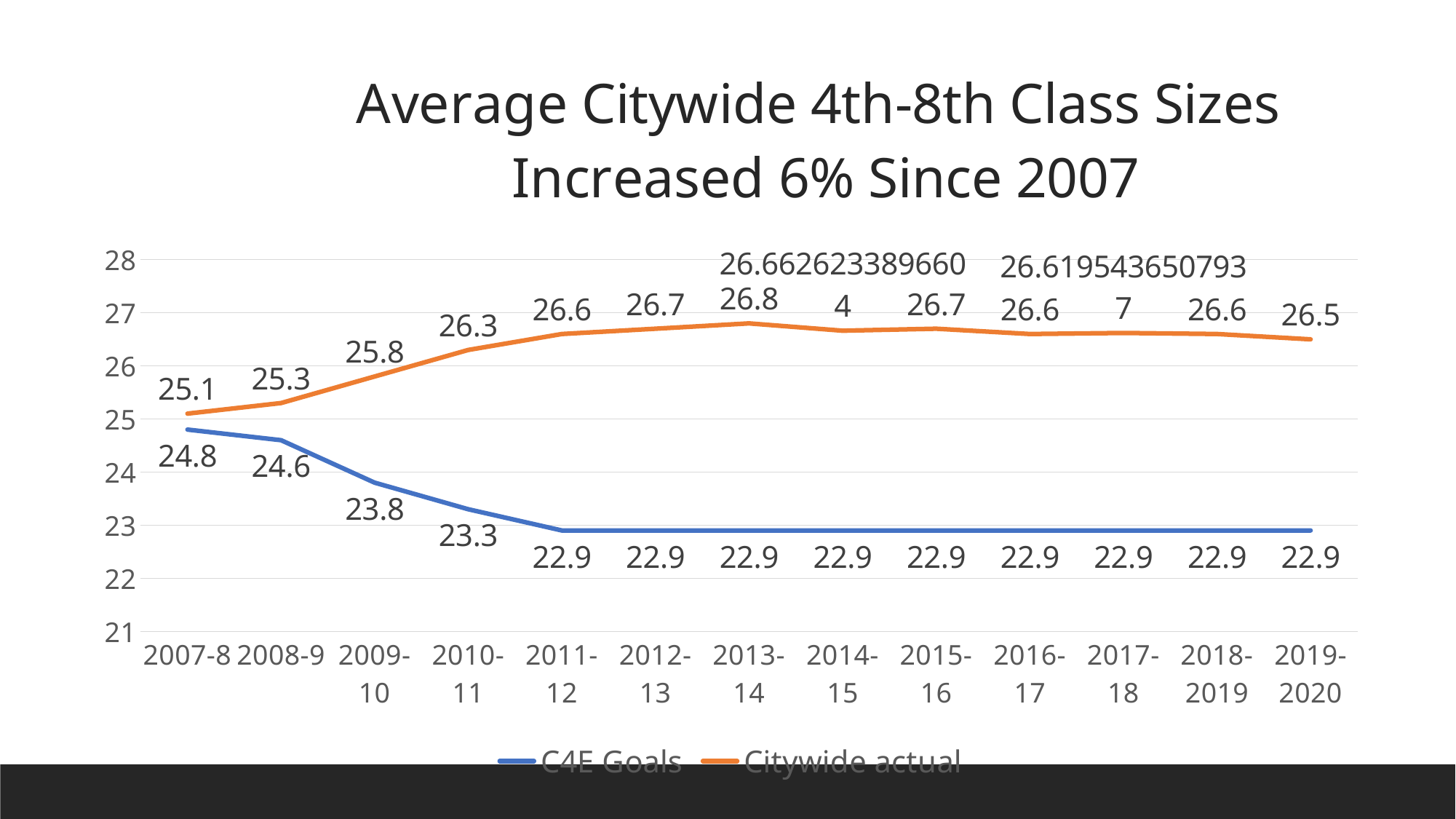
What is the C4E Goals value for 2010-11? 23.3 Which series has the larger value in 2009-10, C4E Goals or Citywide actual? Citywide actual What is the title of the chart? Average Citywide 4th-8th Class Sizes Increased 6% Since 2007 What is the Citywide actual value for 2007-8? 25.1 How many school years are plotted along the x axis? 13 Does the C4E Goals series rise or fall from 2007-8 to 2011-12? Fall What is the lowest value of the C4E Goals series? 22.9 What is the difference between the Citywide actual and C4E Goals values in 2011-12? 3.7 In which school year does the Citywide actual series reach its highest labelled value? 2013-14 What is the Citywide actual value for 2019-2020? 26.5 What kind of chart is shown on the slide? Line chart How many series does the legend list? 2